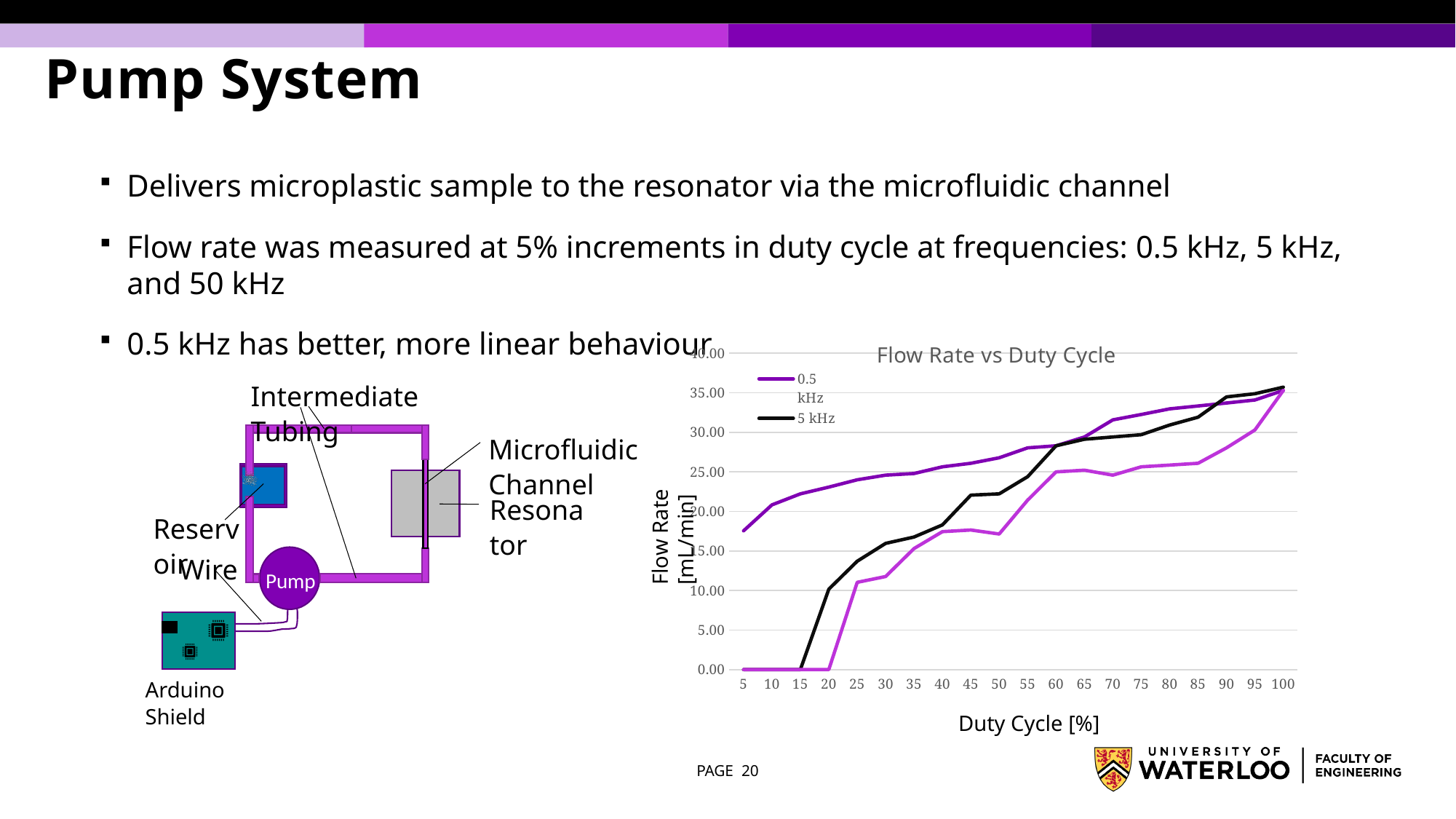
How many duty cycle values are marked along the x axis of the "Flow Rate vs Duty Cycle" chart? 20 How many series does the legend of the "Flow Rate vs Duty Cycle" chart list? 2 In the "Flow Rate vs Duty Cycle" chart, which series has the higher flow rate at a 40% duty cycle, 0.5 kHz or 5 kHz? 0.5 kHz What kind of chart is "Flow Rate vs Duty Cycle"? Line chart In the "Flow Rate vs Duty Cycle" chart, is the flow rate for 0.5 kHz at a 5% duty cycle greater or less than 15.00? greater In the "Flow Rate vs Duty Cycle" chart, does the flow rate for 0.5 kHz rise or fall as duty cycle increases? Rise In the "Flow Rate vs Duty Cycle" chart, is the flow rate for 0.5 kHz at a 60% duty cycle greater or less than 25.00? greater In the "Flow Rate vs Duty Cycle" chart, which series has the higher flow rate at a 30% duty cycle, 0.5 kHz or 5 kHz? 0.5 kHz In the "Flow Rate vs Duty Cycle" chart, is the flow rate for 0.5 kHz at a 5% duty cycle greater or less than 20.00? less What is the title of the chart on the slide? Flow Rate vs Duty Cycle What is the label of the x axis of the "Flow Rate vs Duty Cycle" chart? Duty Cycle [%]